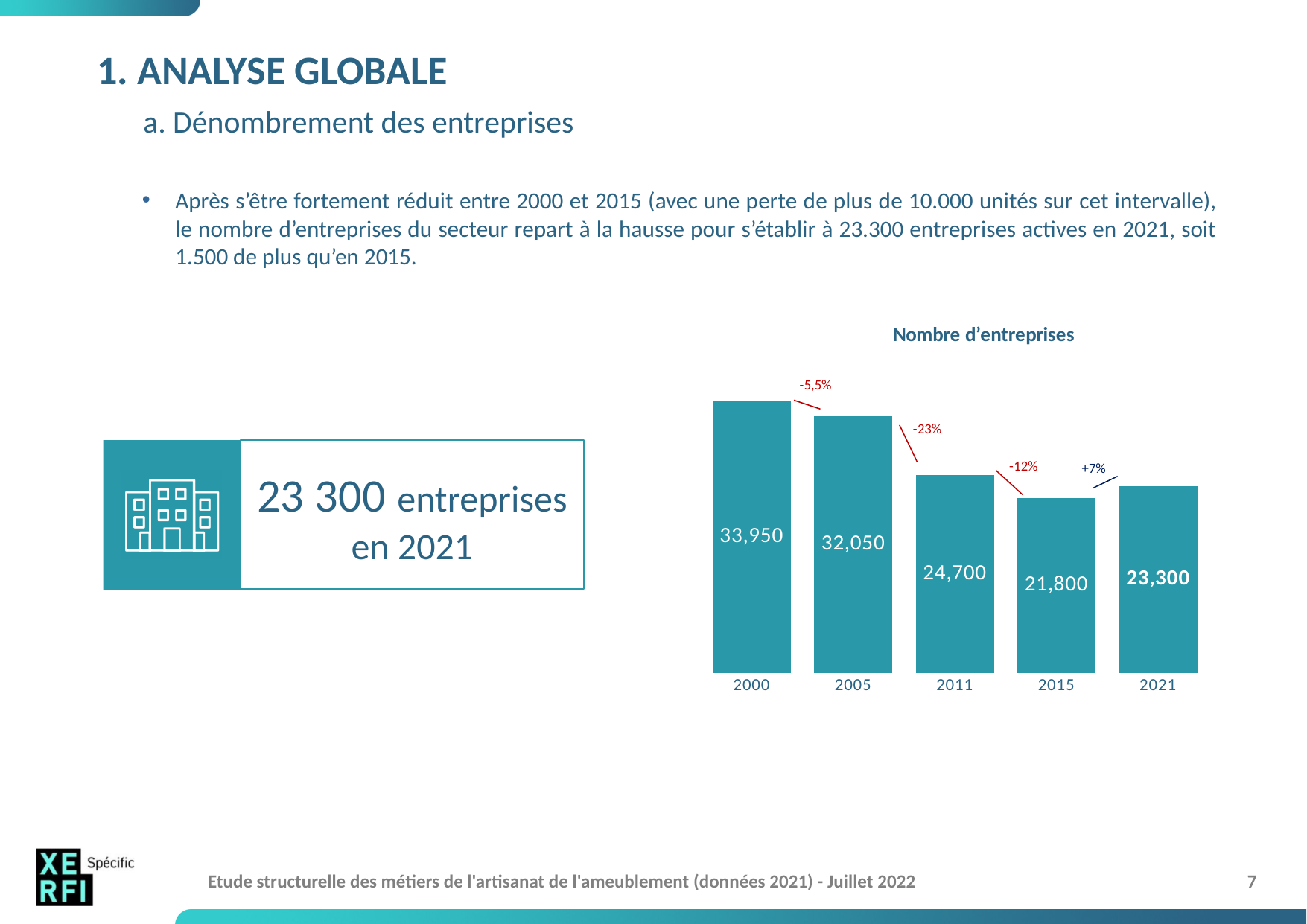
What is the number of enterprises shown for 2021? 23,300 Which year has the lowest number of enterprises? 2015 What is the number of enterprises shown for 2011? 24,700 What percentage change is annotated between 2005 and 2011? -23% How many years are shown on the x axis of the chart? 5 Which year has more enterprises, 2011 or 2021? 2011 Which year has the highest number of enterprises? 2000 What is the number of enterprises shown for 2000 in the 'Nombre d'entreprises' chart? 33,950 What is the number of enterprises shown for 2015? 21,800 What is the difference between the number of enterprises in 2021 and in 2015? 1,500 What kind of chart is used to show the number of enterprises? Bar chart What is the difference between the number of enterprises in 2000 and in 2005? 1,900